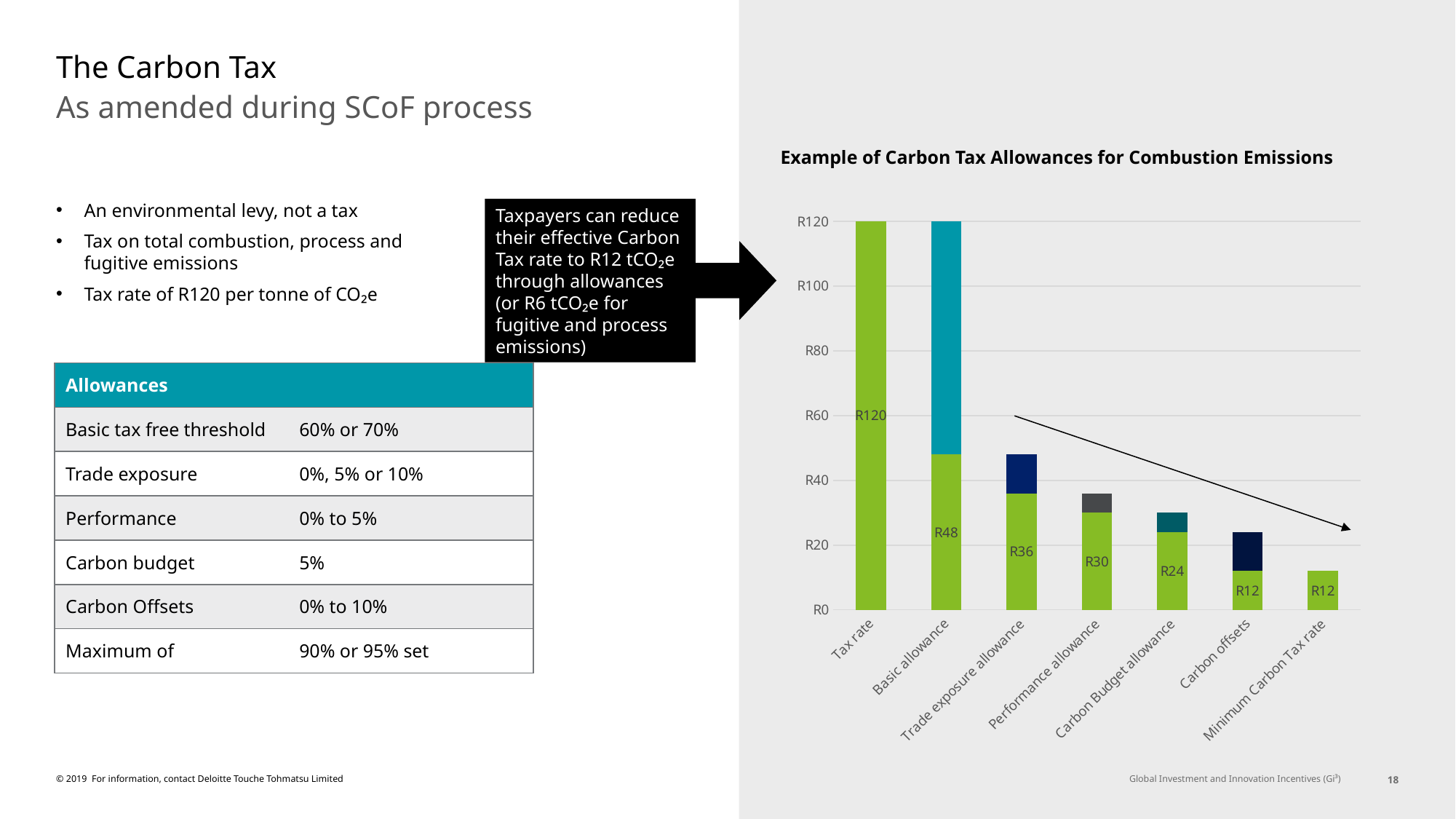
Is the total height of the Basic allowance stacked bar greater or less than R100? greater What kind of chart is shown on the slide? Bar chart What is the difference between the Tax rate value and the labelled value on the Basic allowance green segment? R72 What value is labelled on the Minimum Carbon Tax rate bar? R12 What value is labelled on the Performance allowance bar? R30 How many categories are shown on the x axis? 7 What value is labelled on the green segment of the Basic allowance bar? R48 What is the value labelled on the Tax rate bar? R120 Which is larger, the labelled value for Trade exposure allowance or for Carbon Budget allowance? Trade exposure allowance Which category has the highest labelled value? Tax rate What value is labelled on the Trade exposure allowance bar? R36 Do the labelled green values rise or fall from left to right along the x axis? Fall